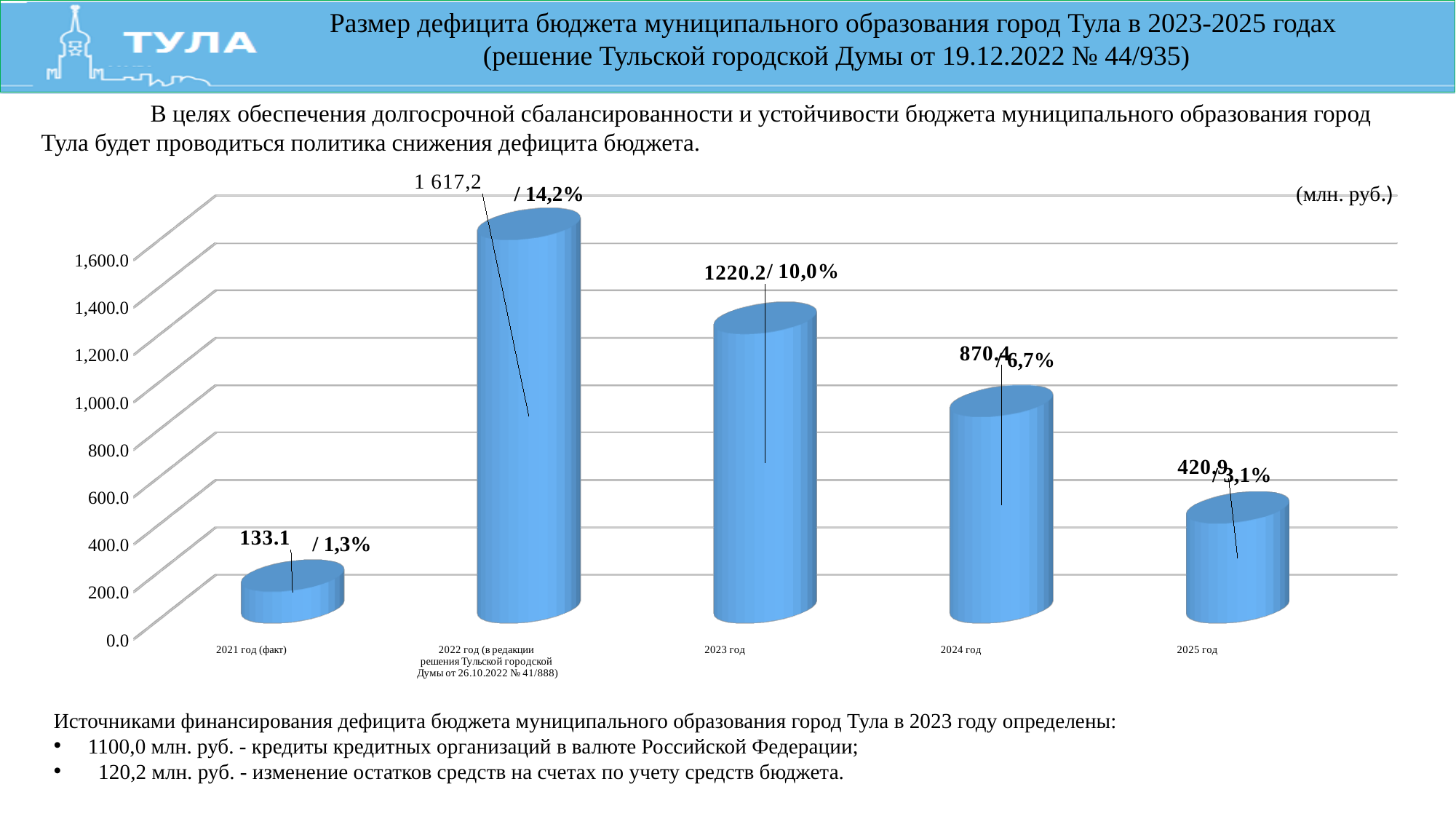
What is the budget deficit value for 2021 год (факт)? 133.1 What type of chart is shown on the slide? bar chart How many bars (years) are plotted in the chart? 5 What is the budget deficit value for 2023 год? 1220.2 What is the difference between the values for 2023 год and 2024 год? 349.8 Do the values rise or fall from 2022 год to 2025 год? fall What unit is indicated for the chart values? млн. руб. Which is larger, the value for 2024 год or the value for 2025 год? 2024 год What percentage is shown next to the 2024 год bar? 6,7% What is the budget deficit value for 2025 год? 420.9 Which year has the lowest budget deficit? 2021 год (факт) Which year has the highest budget deficit? 2022 год